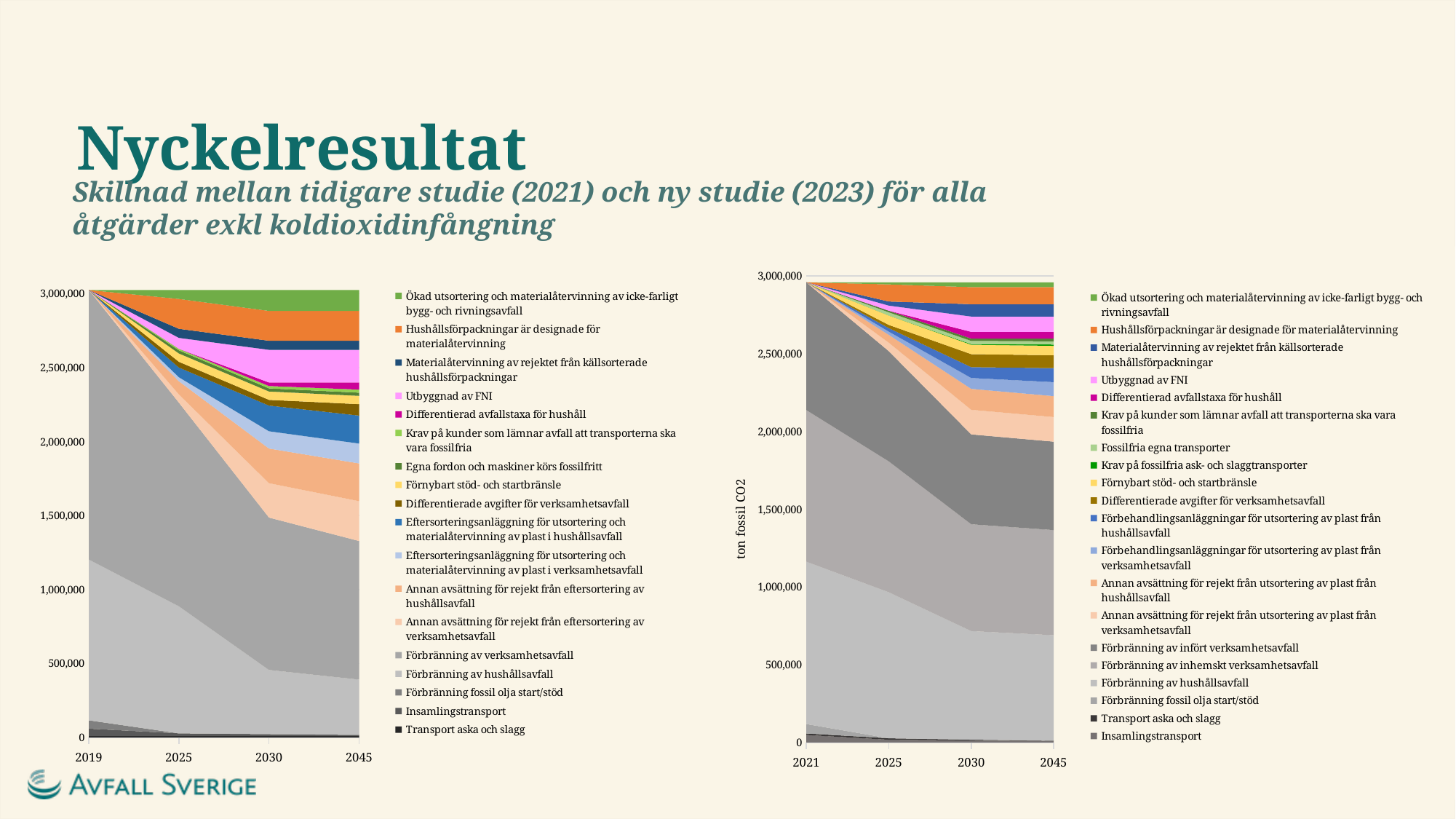
In the left chart, does the total stacked value rise or fall from 2019 to 2045? Neither; the total stays flat at about 3,000,000 How many series does the legend of the left chart list? 18 What kind of chart is the left chart on the slide? Stacked area chart How many years are shown on the x axis of the right chart? 4 How many years are shown on the x axis of the left chart? 4 In the left chart, is the value for Förbränning av hushållsavfall in 2045 greater or less than 500,000? less In the right chart, does the total stacked value rise or fall from 2021 to 2045? Neither; the total stays flat at about 3,000,000 What is the first year on the x axis of the right chart? 2021 How many series does the legend of the right chart list? 20 In the right chart, is the value for Förbränning av hushållsavfall in 2045 greater or less than 500,000? greater What is the first year on the x axis of the left chart? 2019